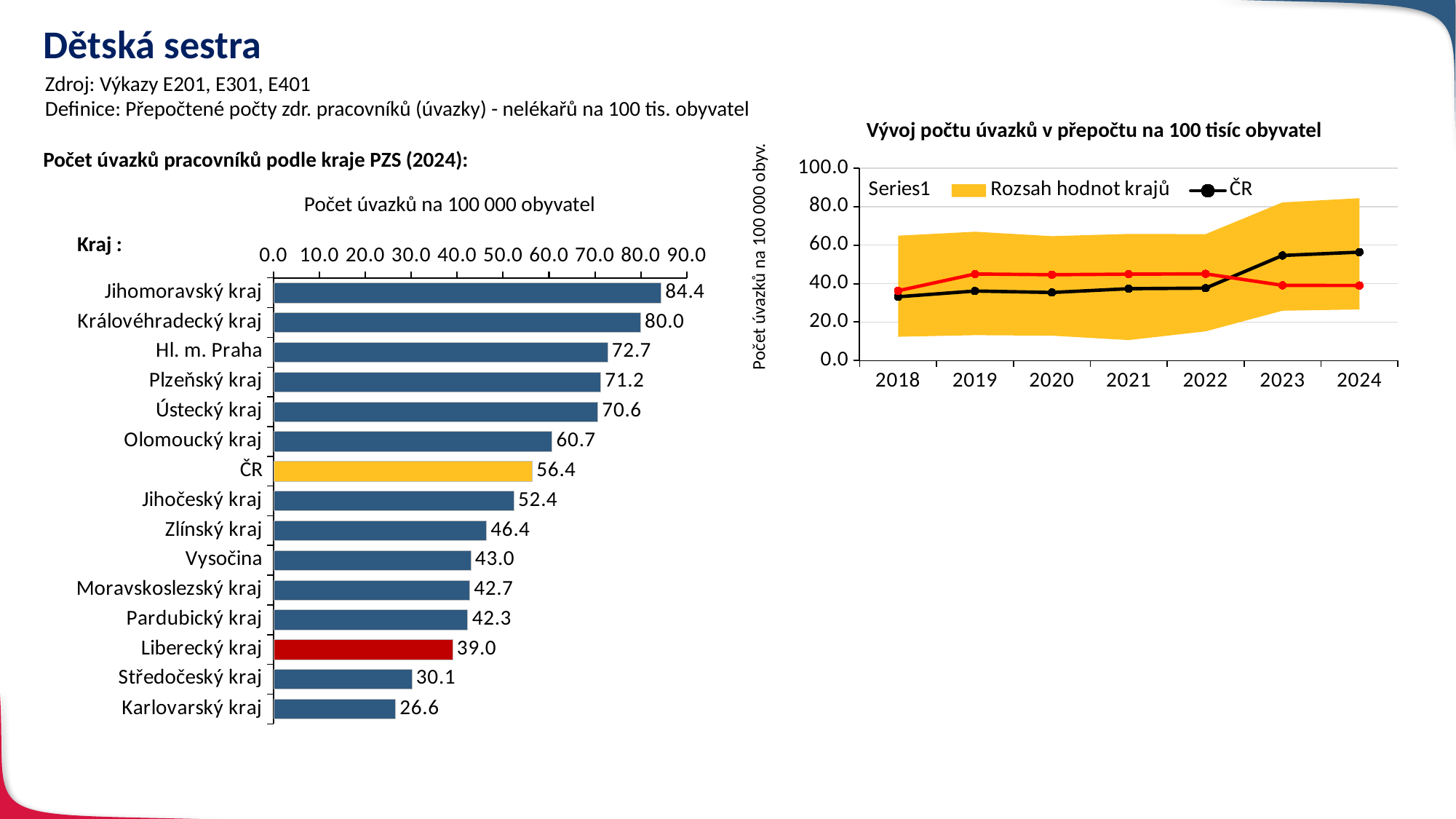
In the bar chart 'Počet úvazků pracovníků podle kraje PZS (2024)', what is the value for ČR? 56.4 In the bar chart 'Počet úvazků pracovníků podle kraje PZS (2024)', what is the difference between Královéhradecký kraj and Liberecký kraj? 41.0 What type of chart is 'Počet úvazků pracovníků podle kraje PZS (2024)'? Bar chart In the chart 'Vývoj počtu úvazků v přepočtu na 100 tisíc obyvatel', does the ČR line rise or fall from 2018 to 2024? Rise How many bars are shown in the bar chart 'Počet úvazků pracovníků podle kraje PZS (2024)'? 15 In the bar chart 'Počet úvazků pracovníků podle kraje PZS (2024)', which region has the highest value? Jihomoravský kraj How many entries does the legend list in the chart 'Vývoj počtu úvazků v přepočtu na 100 tisíc obyvatel'? 3 In the bar chart 'Počet úvazků pracovníků podle kraje PZS (2024)', what is the value for Jihomoravský kraj? 84.4 In the chart 'Vývoj počtu úvazků v přepočtu na 100 tisíc obyvatel', is the ČR value for 2024 greater or less than 40.0? greater In the bar chart 'Počet úvazků pracovníků podle kraje PZS (2024)', which region has the lowest value? Karlovarský kraj In the bar chart 'Počet úvazků pracovníků podle kraje PZS (2024)', which is larger: Plzeňský kraj or Ústecký kraj? Plzeňský kraj In the bar chart 'Počet úvazků pracovníků podle kraje PZS (2024)', which bar is coloured red? Liberecký kraj